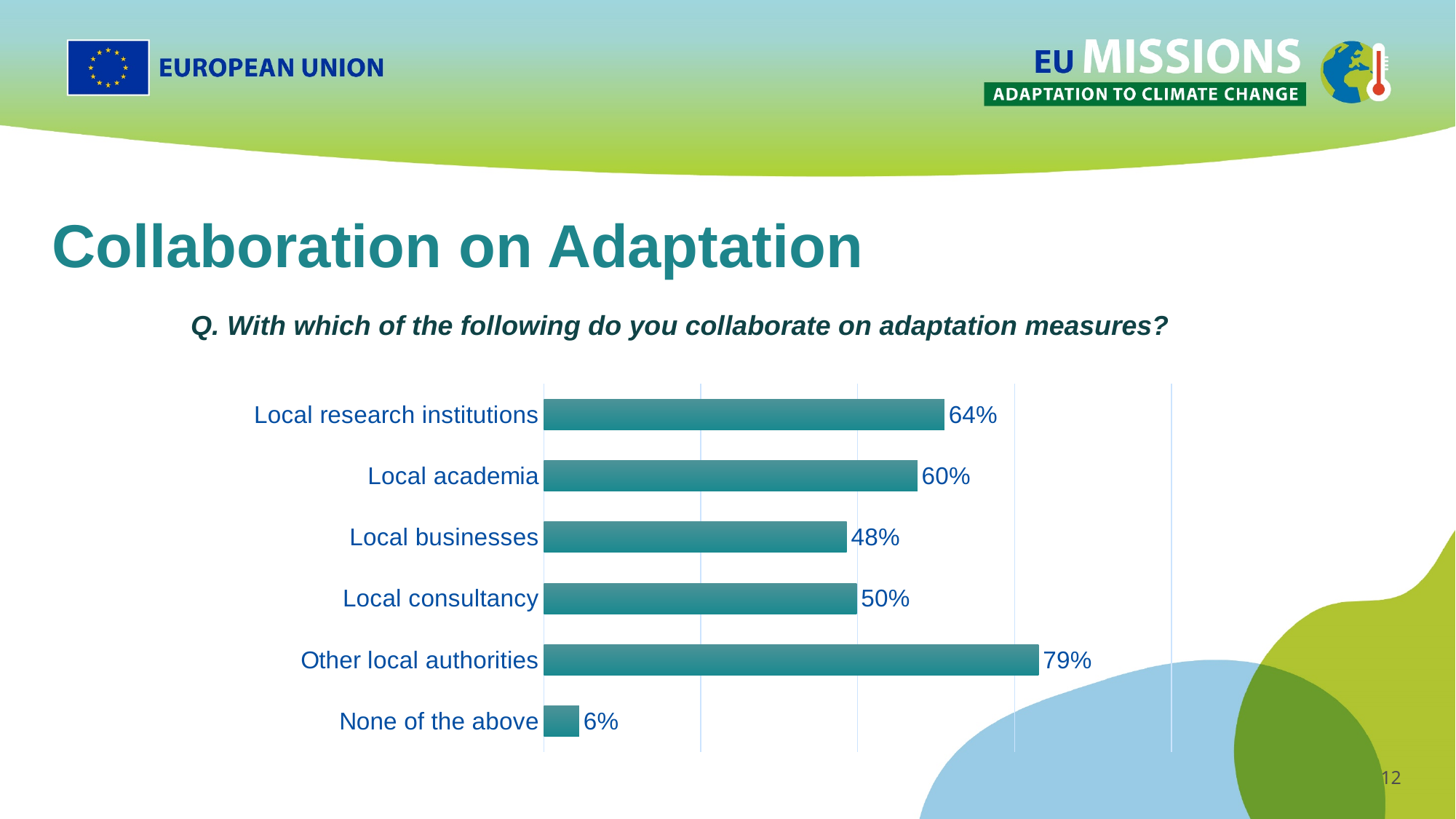
Which category has the highest value in the chart? Other local authorities What kind of chart is shown on the slide? Bar chart What is the value shown for Local consultancy? 50% Which category has the lowest value in the chart? None of the above What is the value shown for Local academia? 60% What is the value shown for None of the above? 6% What is the value shown for Local businesses? 48% What is the difference between the values for Other local authorities and Local research institutions? 15% Which is larger, the value for Local businesses or the value for Local consultancy? Local consultancy What survey question is the chart based on? With which of the following do you collaborate on adaptation measures? What percentage of respondents collaborate with local research institutions on adaptation measures? 64% How many categories are shown in the chart? 6